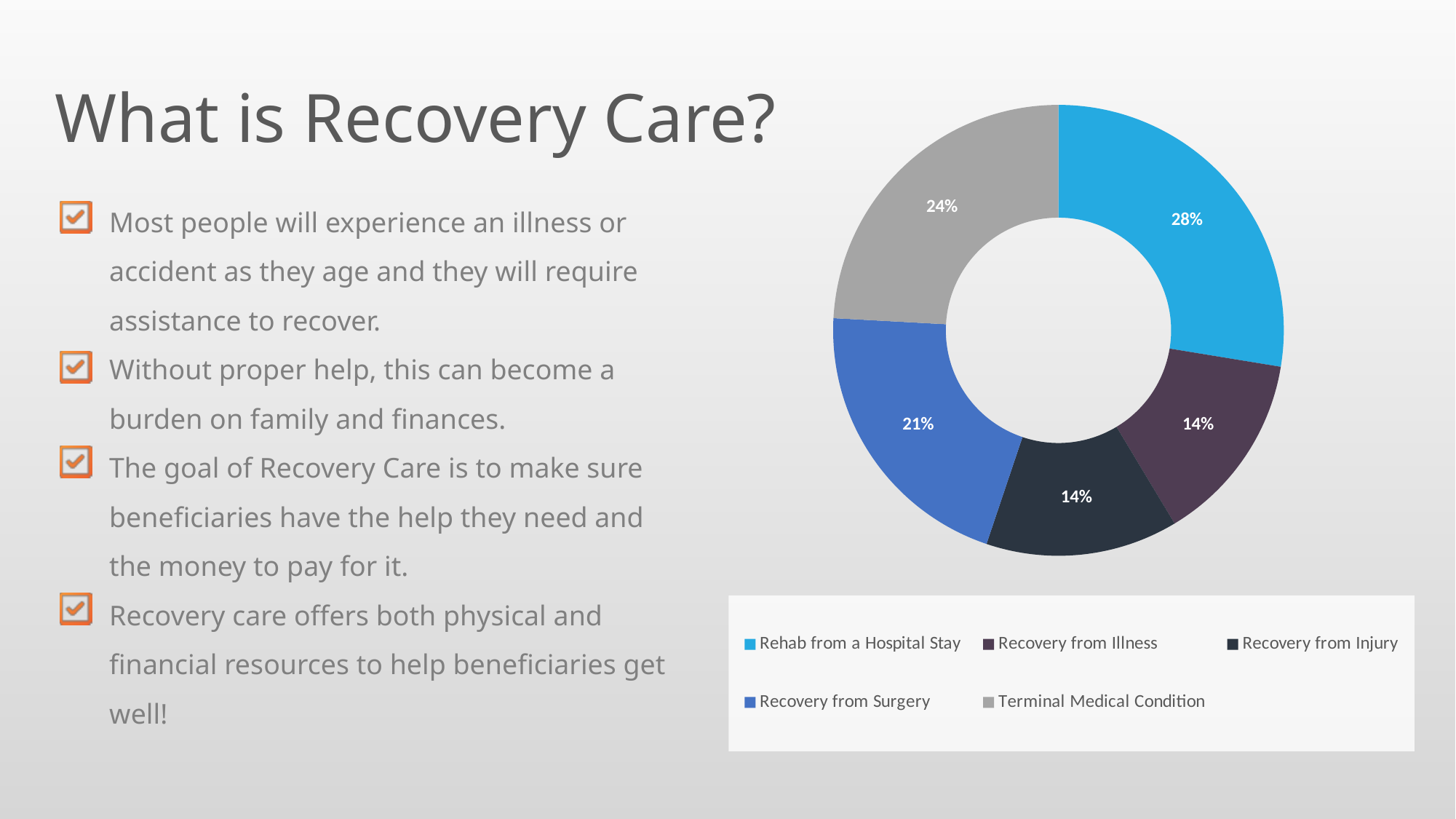
What percentage is shown for Recovery from Injury? 14% What is the difference in percentage points between Rehab from a Hospital Stay and Terminal Medical Condition? 4 What percentage is shown for Recovery from Illness? 14% Which legend entry is shown in grey? Terminal Medical Condition What is the difference in percentage points between Recovery from Surgery and Recovery from Injury? 7 Which category has the largest share of the chart? Rehab from a Hospital Stay What is the value shown for Recovery from Surgery? 21% How many categories does the chart show? 5 What percentage of the chart is Rehab from a Hospital Stay? 28% Which is larger, Terminal Medical Condition or Recovery from Surgery? Terminal Medical Condition What kind of chart is shown on the slide? doughnut chart What percentage does the Terminal Medical Condition slice show? 24%